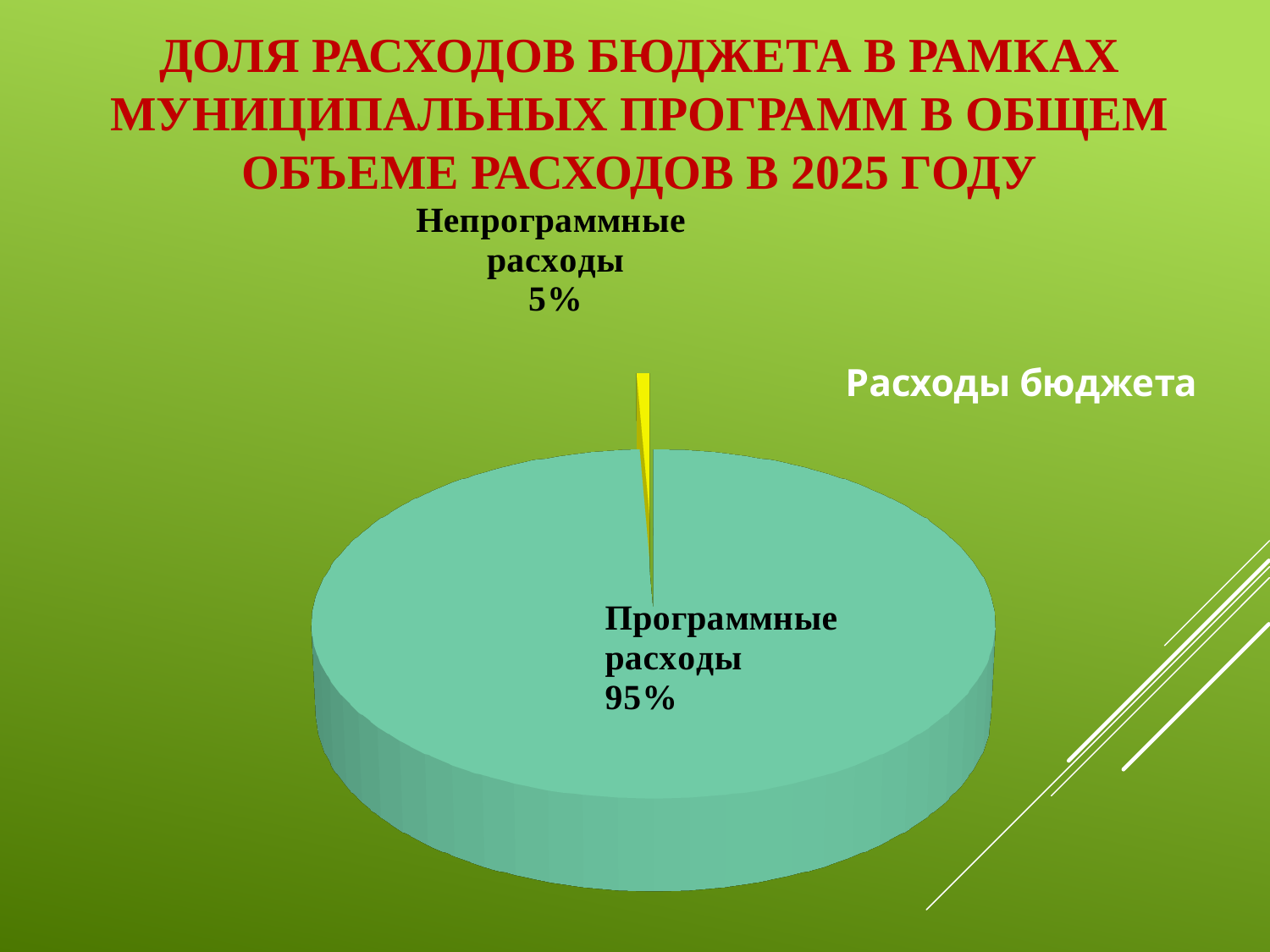
What share of the pie is labelled "Непрограммные расходы"? 5% What is the title of the chart? Расходы бюджета Which is larger: the "Программные расходы" slice or the "Непрограммные расходы" slice? Программные расходы What is the difference in percentage points between the "Программные расходы" and "Непрограммные расходы" slices? 90 What kind of chart is shown on the slide? Pie chart What colour is the "Непрограммные расходы" slice? Yellow Which slice of the pie is the largest? Программные расходы Which slice of the pie is the smallest? Непрограммные расходы What is the total of the two slice percentages shown on the pie? 100% What share of the pie is labelled "Программные расходы"? 95% How many slices does the pie chart have? 2